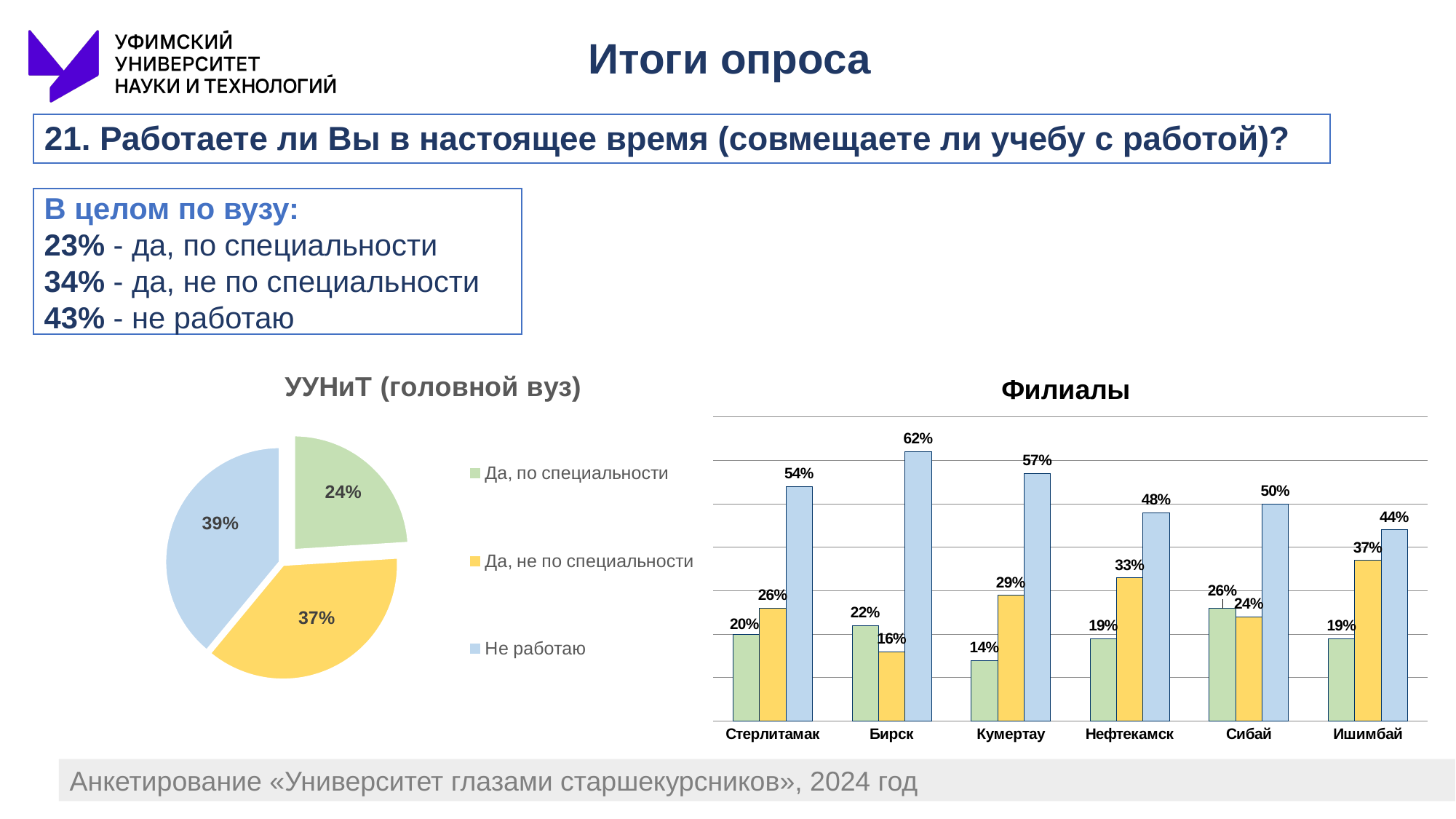
How many entries does the legend of the "УУНиТ (головной вуз)" pie chart list? 3 In the "Филиалы" bar chart, which branch has the highest blue bar? Бирск In the "Филиалы" bar chart, what is the value of the blue bar for Бирск? 62% In the "Филиалы" bar chart, what is the value of the yellow bar for Ишимбай? 37% In the "Филиалы" bar chart, what is the difference between the blue bar for Бирск and the blue bar for Ишимбай? 18% In the "УУНиТ (головной вуз)" pie chart, which category has the largest slice? Не работаю In the "Филиалы" bar chart, which branch has the lowest green bar? Кумертау What kind of chart is the "Филиалы" chart? bar chart How many branches are shown on the x axis of the "Филиалы" bar chart? 6 What kind of chart is the "УУНиТ (головной вуз)" chart? pie chart In the "УУНиТ (головной вуз)" pie chart, what is the value for "Да, по специальности"? 24% In the "УУНиТ (головной вуз)" pie chart, what share does "Не работаю" have? 39%